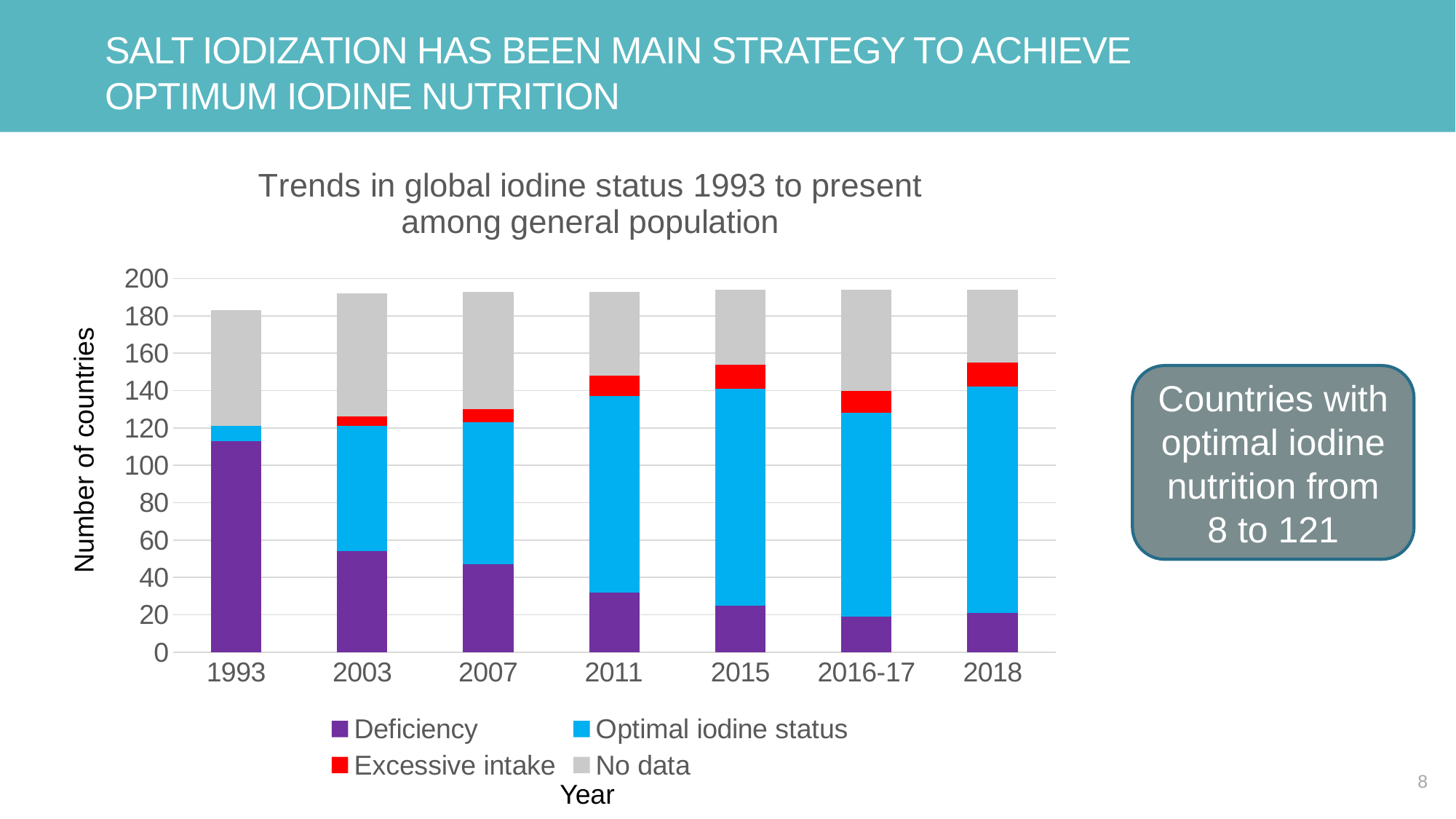
Is the number of countries with iodine deficiency in 2018 greater or less than 40? less Does the number of countries with iodine deficiency rise or fall from 1993 to 2018? Fall Which year has the highest number of countries with optimal iodine status? 2018 What is the label of the y axis of the chart? Number of countries Which year has the highest number of countries with iodine deficiency? 1993 How many years (categories) are shown on the x axis of the chart? 7 Is the number of countries with iodine deficiency in 1993 greater or less than 100? greater What kind of chart is shown on the slide? Stacked bar chart Which year has more countries with optimal iodine status, 2007 or 2011? 2011 Which year has the lowest number of countries with optimal iodine status? 1993 What is the title of the chart? Trends in global iodine status 1993 to present among general population How many series does the chart's legend list? 4